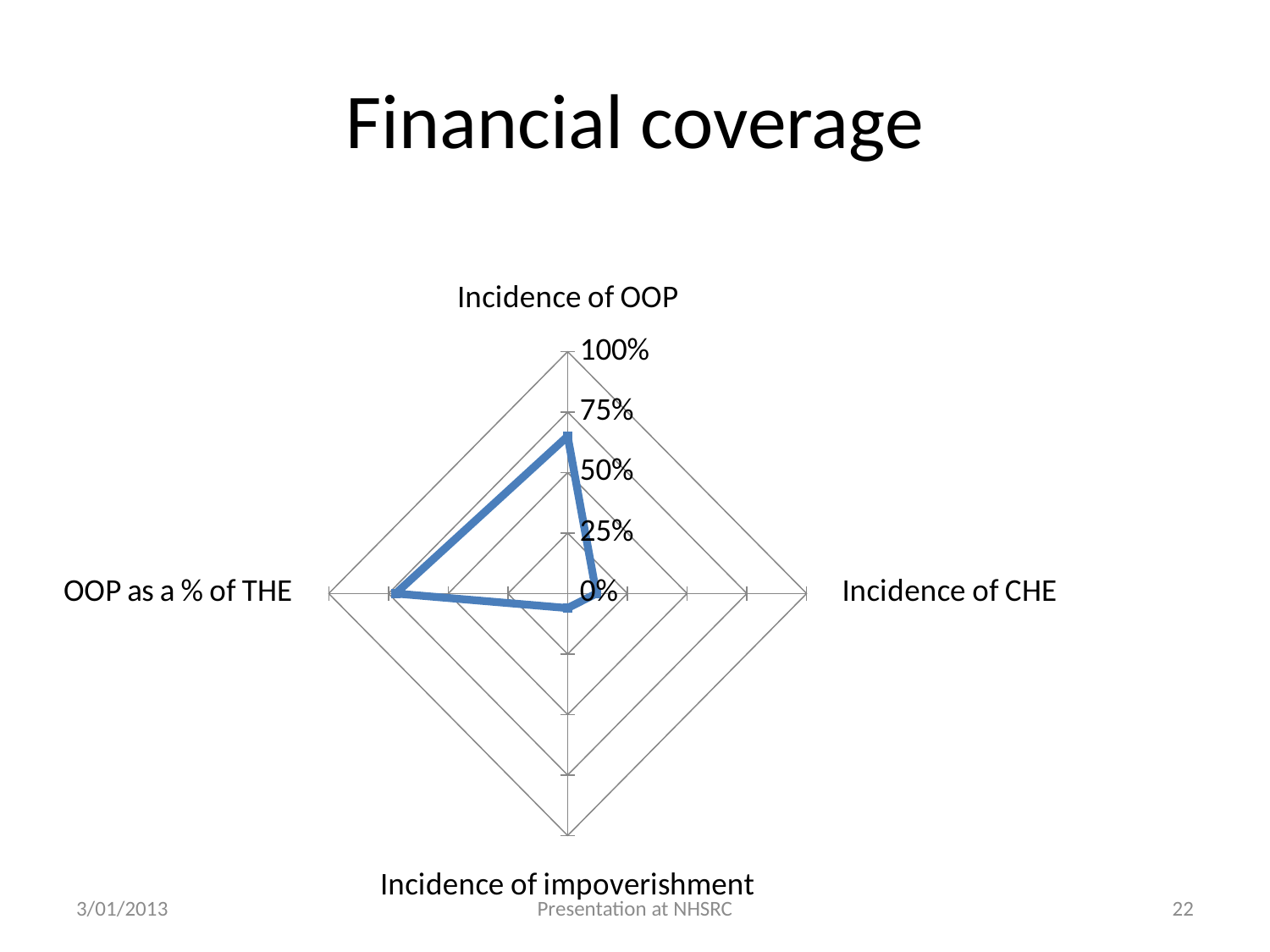
What is the maximum value shown on the radar chart's axis scale? 100% What is the title of the chart on the slide? Financial coverage Is the value for Incidence of OOP greater or less than 75%? less Is the value for Incidence of CHE greater or less than 25%? less Is the value for OOP as a % of THE greater or less than 50%? greater Which is larger, the value for OOP as a % of THE or the value for Incidence of impoverishment? OOP as a % of THE Which is larger, the value for Incidence of OOP or the value for Incidence of CHE? Incidence of OOP How many categories (axes) does the radar chart have? 4 What kind of chart is shown on the slide? Radar chart